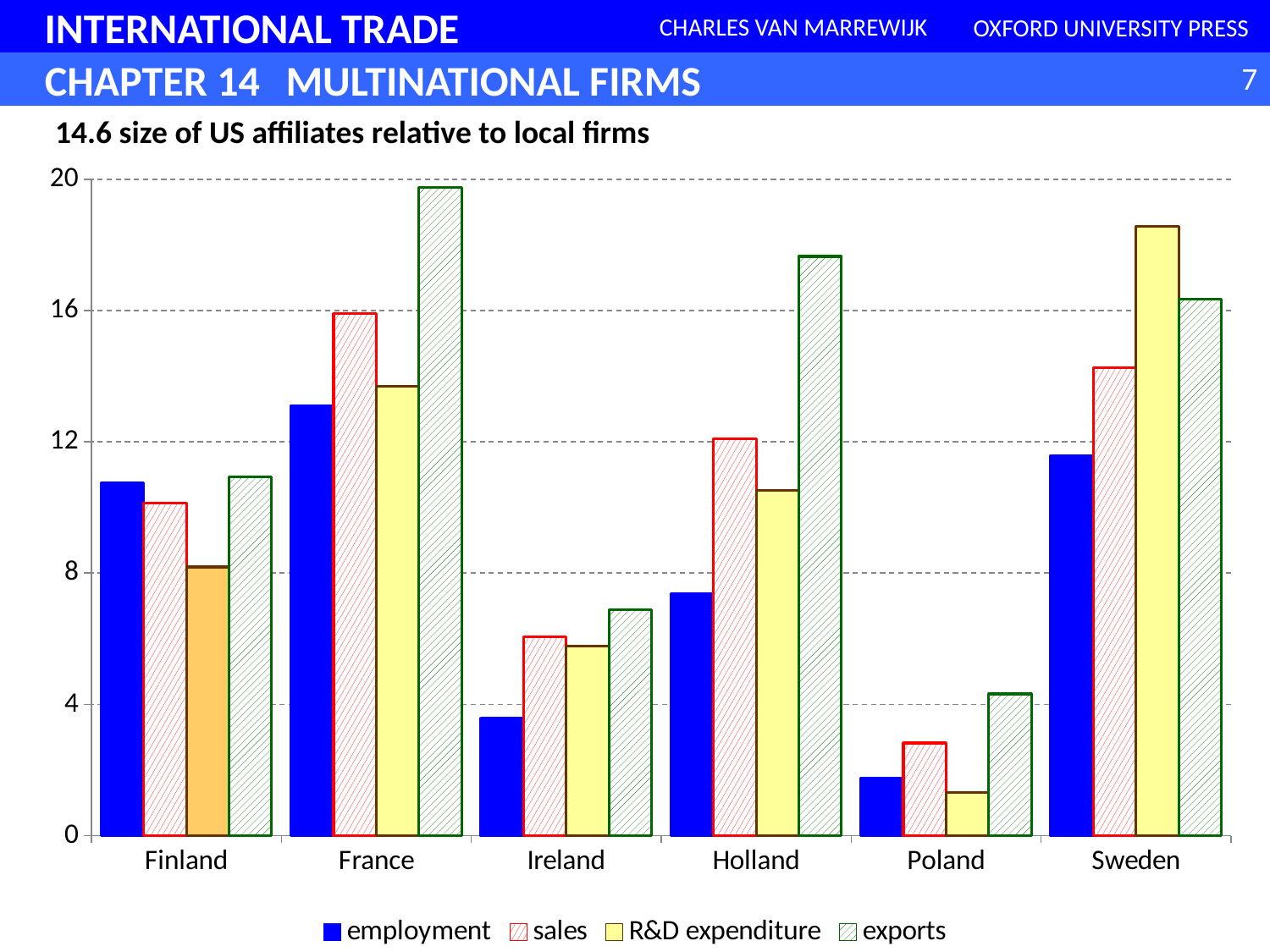
Is the employment value for Ireland greater or less than 4? less For Sweden, which is larger: R&D expenditure or exports? R&D expenditure Is the sales value for Poland greater or less than 4? less Which country has the highest R&D expenditure value? Sweden Which country has the highest exports value? France Which country has the lowest employment value? Poland How many countries are shown on the x axis of the chart? 6 For Holland, which is larger: sales or employment? sales How many series does the legend list? 4 What kind of chart is shown on the slide? bar chart Which country has the highest sales value? France Is the exports value for France greater or less than 16? greater